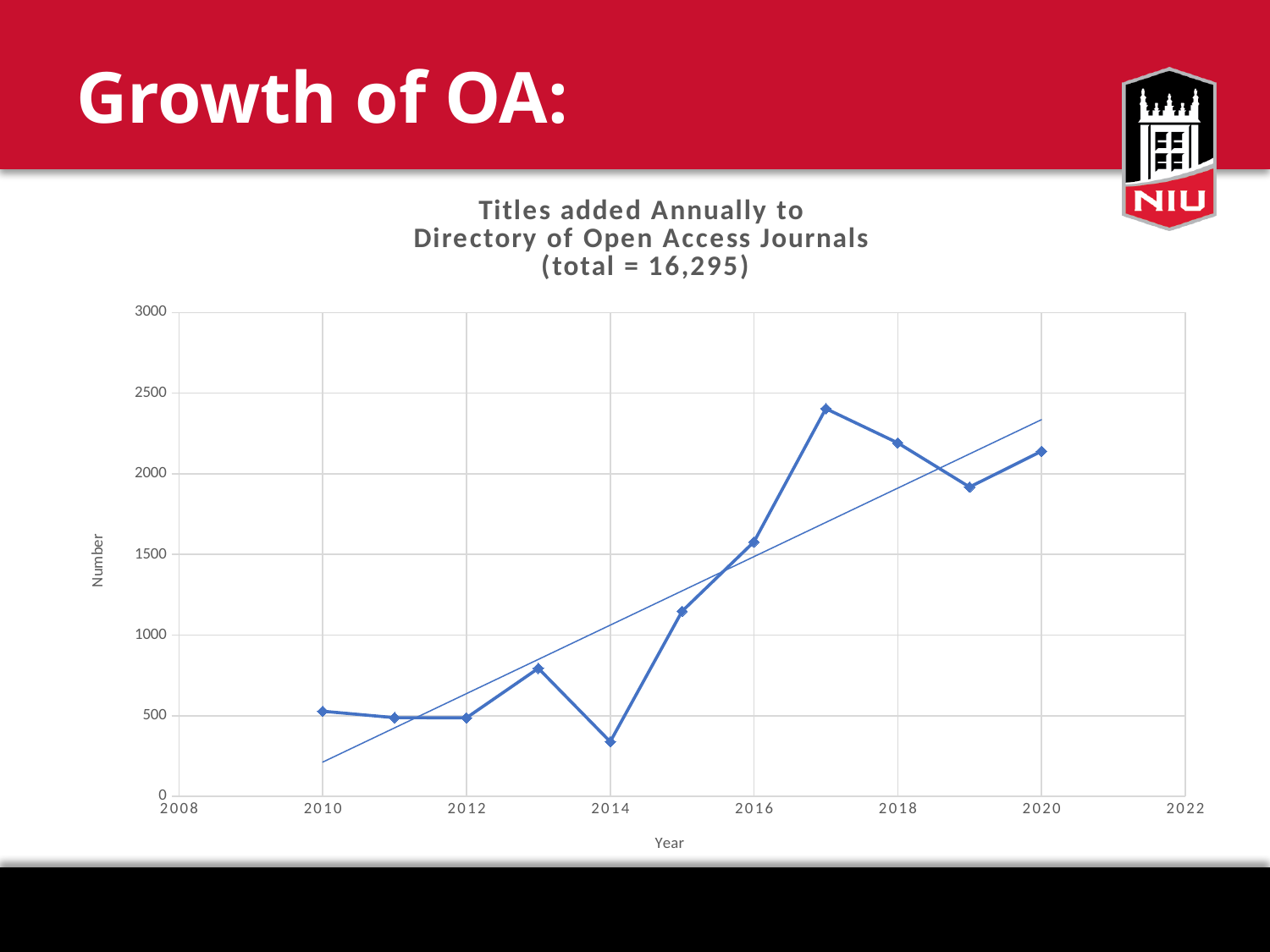
Which year has the highest number of titles added? 2017 What kind of chart is shown on the slide? line chart Which year has the lowest number of titles added? 2014 Is the value for 2017 greater or less than 2000? greater What is the title of the chart? Titles added Annually to Directory of Open Access Journals (total = 16,295) Is the value for 2019 greater or less than 2000? less Which year has the larger value, 2016 or 2013? 2016 Overall, do the values rise or fall from 2010 to 2020? rise Is the value for 2014 greater or less than 500? less What total is stated in the chart title? 16,295 How many data points are plotted on the line? 11